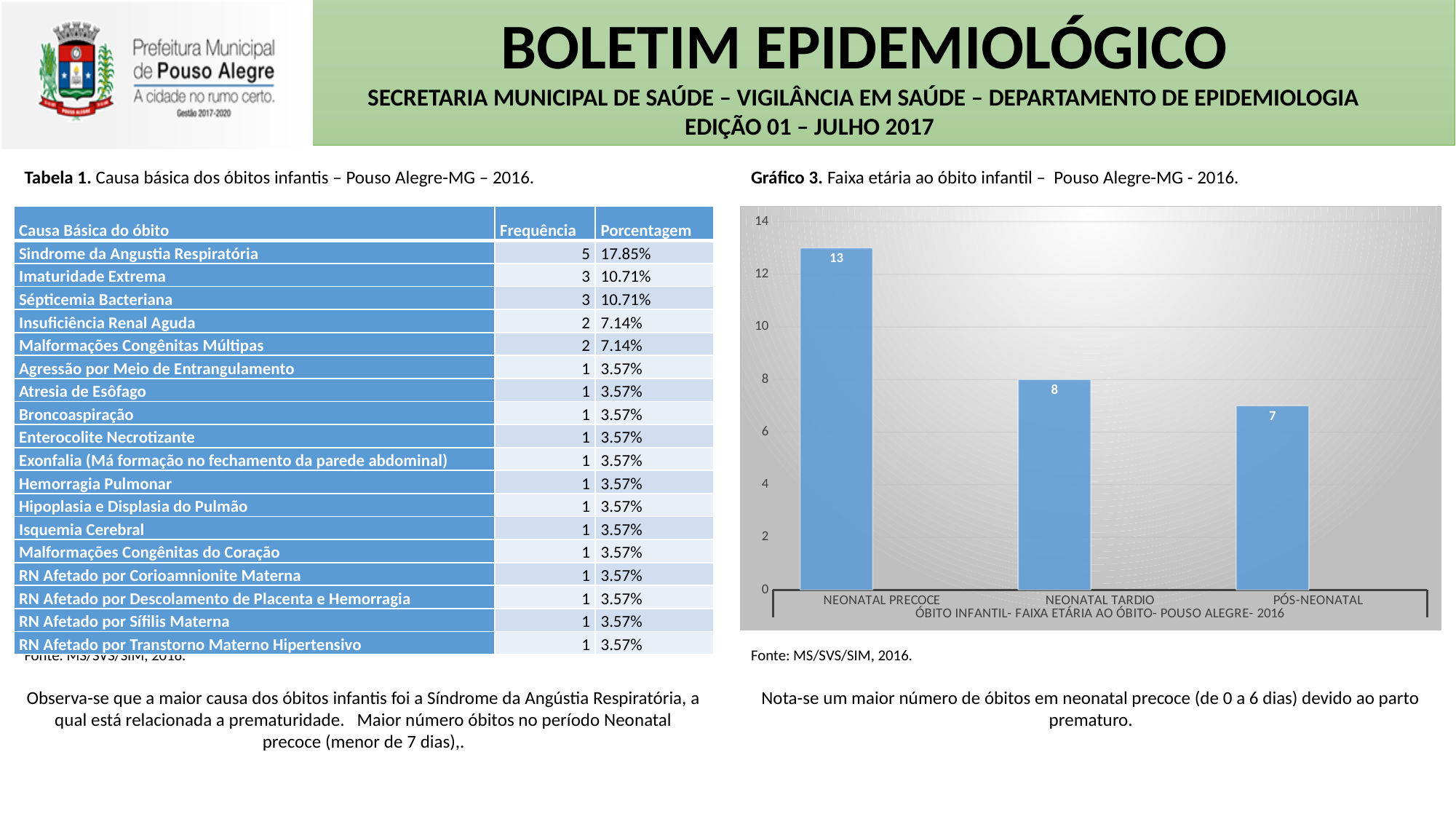
In Gráfico 3, which age group has the highest number of infant deaths? NEONATAL PRECOCE In Gráfico 3, what is the difference between the values for NEONATAL PRECOCE and NEONATAL TARDIO? 5 In Gráfico 3, what is the value for PÓS-NEONATAL? 7 In Gráfico 3, what is the value for NEONATAL PRECOCE? 13 In Gráfico 3, which is larger, the value for NEONATAL TARDIO or PÓS-NEONATAL? NEONATAL TARDIO What kind of chart is Gráfico 3? bar chart In Gráfico 3, what is the value for NEONATAL TARDIO? 8 In Gráfico 3, is the value for NEONATAL PRECOCE greater or less than 10? greater In Gráfico 3, what is the difference between the values for NEONATAL PRECOCE and PÓS-NEONATAL? 6 In Gráfico 3, which age group has the lowest number of infant deaths? PÓS-NEONATAL How many categories are shown in Gráfico 3? 3 Do the values in Gráfico 3 rise or fall from left to right along the x axis? fall